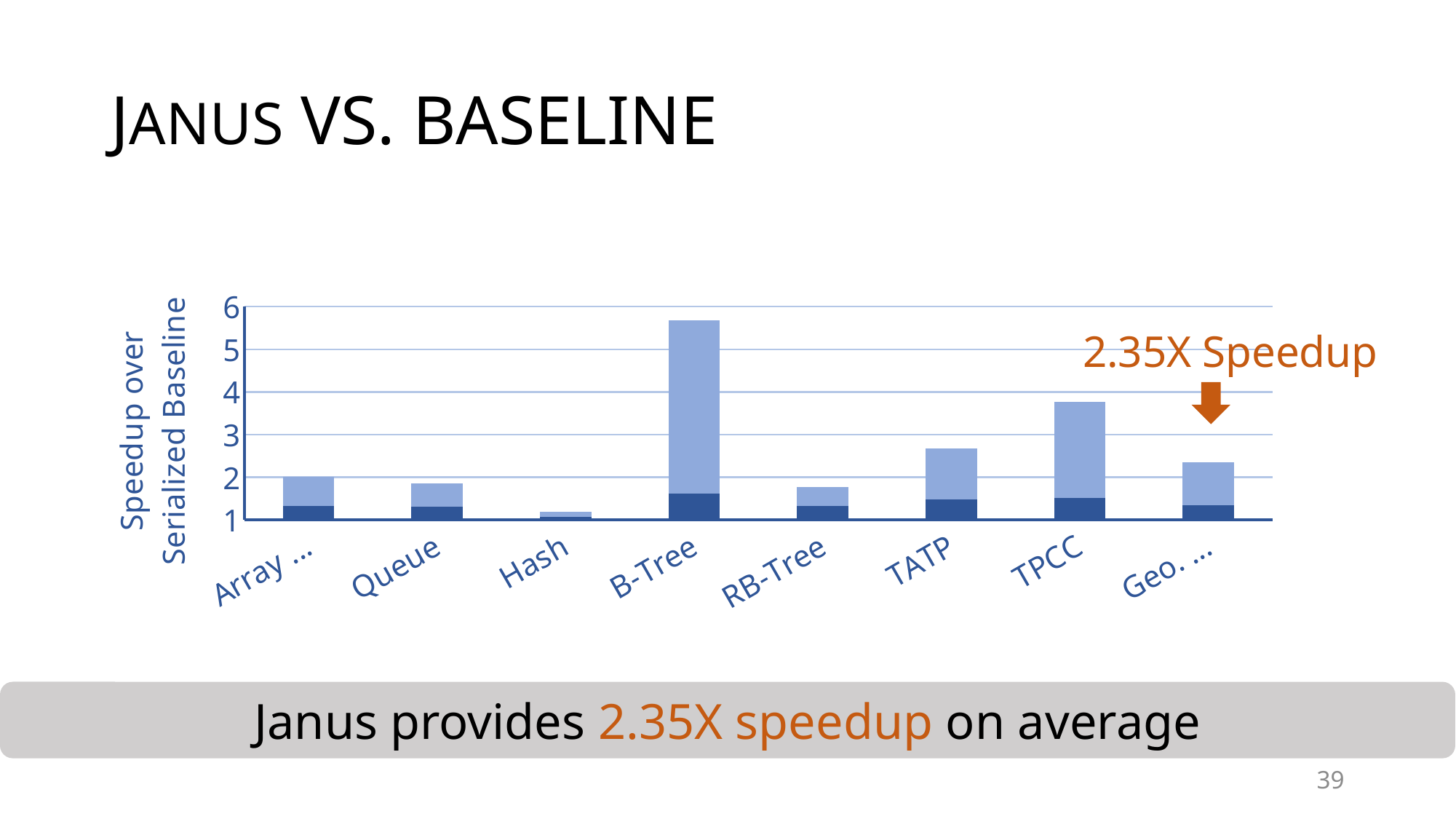
Is the speedup for RB-Tree greater or less than 2? less Is the speedup for TPCC greater or less than 3? greater What kind of chart is shown on the slide? bar chart How many categories are shown on the x axis of the chart? 8 What is the label of the y axis of the chart? Speedup over Serialized Baseline Is the speedup for Hash greater or less than 2? less Which category has the lowest speedup in the chart? Hash Which has a larger speedup, TPCC or TATP? TPCC What speedup value does the annotation with the arrow indicate for the Geo. bar? 2.35X Which category has the highest speedup in the chart? B-Tree